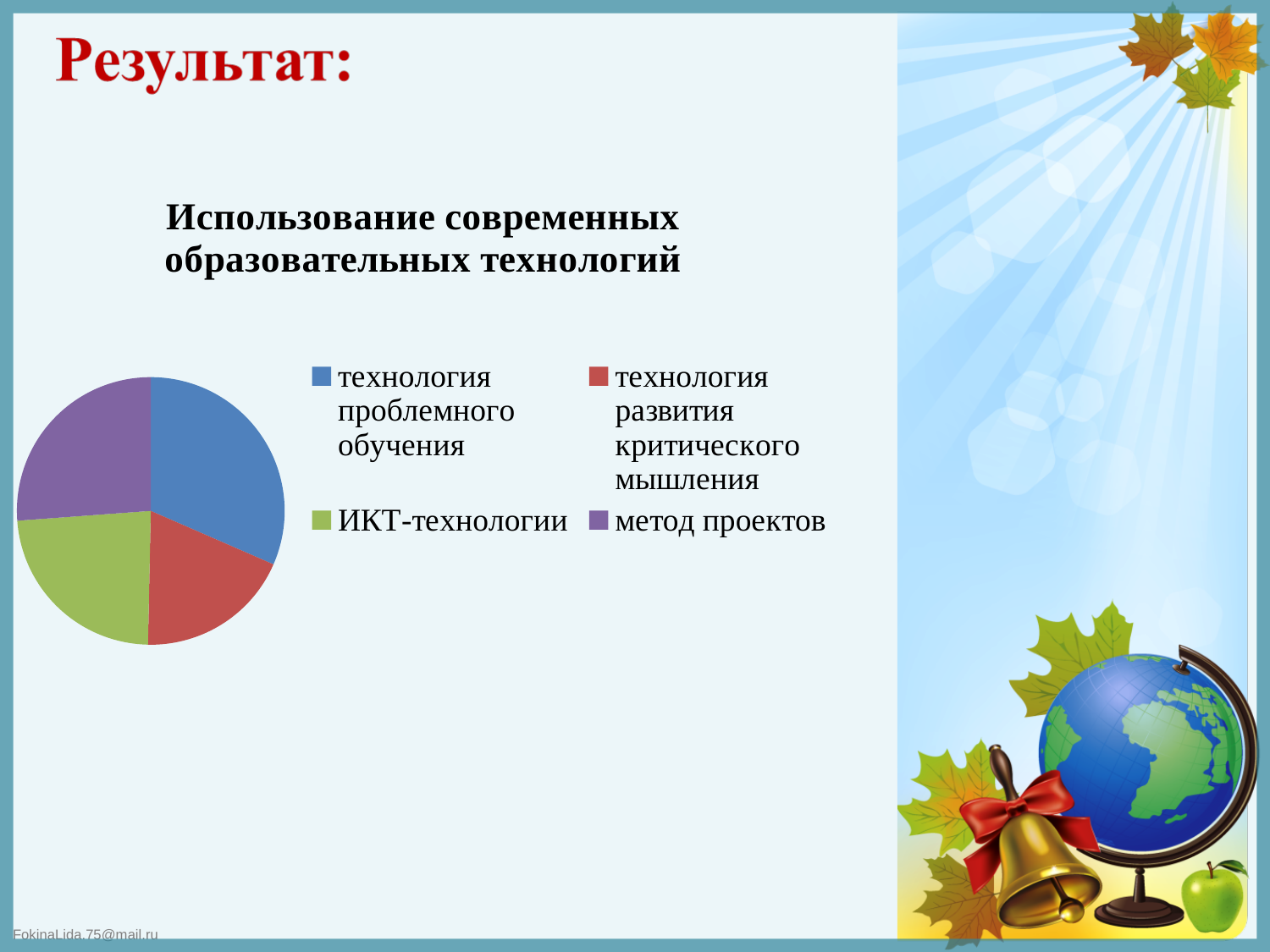
Which category has the smallest slice in the pie chart? технология развития критического мышления How many entries does the legend of the pie chart list? 4 What colour represents ИКТ-технологии in the pie chart? green Which slice is larger: ИКТ-технологии or технология развития критического мышления? ИКТ-технологии Which category has the largest slice in the pie chart? технология проблемного обучения What is the title shown above the pie chart? Использование современных образовательных технологий What kind of chart is shown on the slide? pie chart Which slice is larger: технология проблемного обучения or технология развития критического мышления? технология проблемного обучения How many slices does the pie chart have? 4